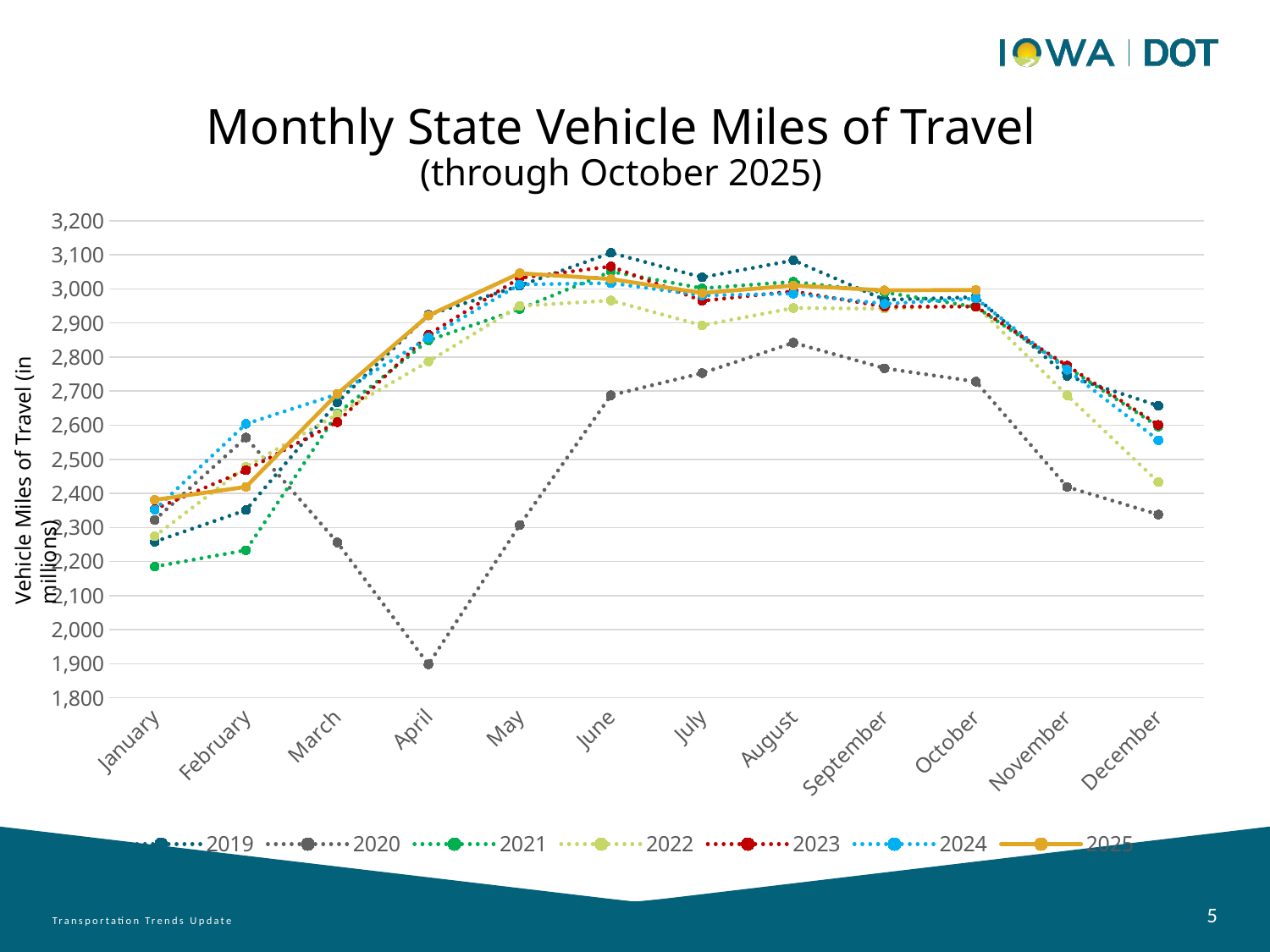
How many months are shown along the x axis? 12 Which year has the lowest value in April? 2020 Is the value for 2020 in December greater or less than 2,400? less Is the value for 2025 in May greater or less than 3,000? greater In which month does the 2020 series reach its lowest value? April Does the 2025 series rise or fall from January to May? Rise What kind of chart is shown on the slide? Line chart Which is larger in April, the value for 2019 or the value for 2020? 2019 In which month does the 2020 series reach its highest value? August How many series does the legend list? 7 Is the value for 2020 in April greater or less than 2,000? less What is the label on the vertical axis? Vehicle Miles of Travel (in millions)